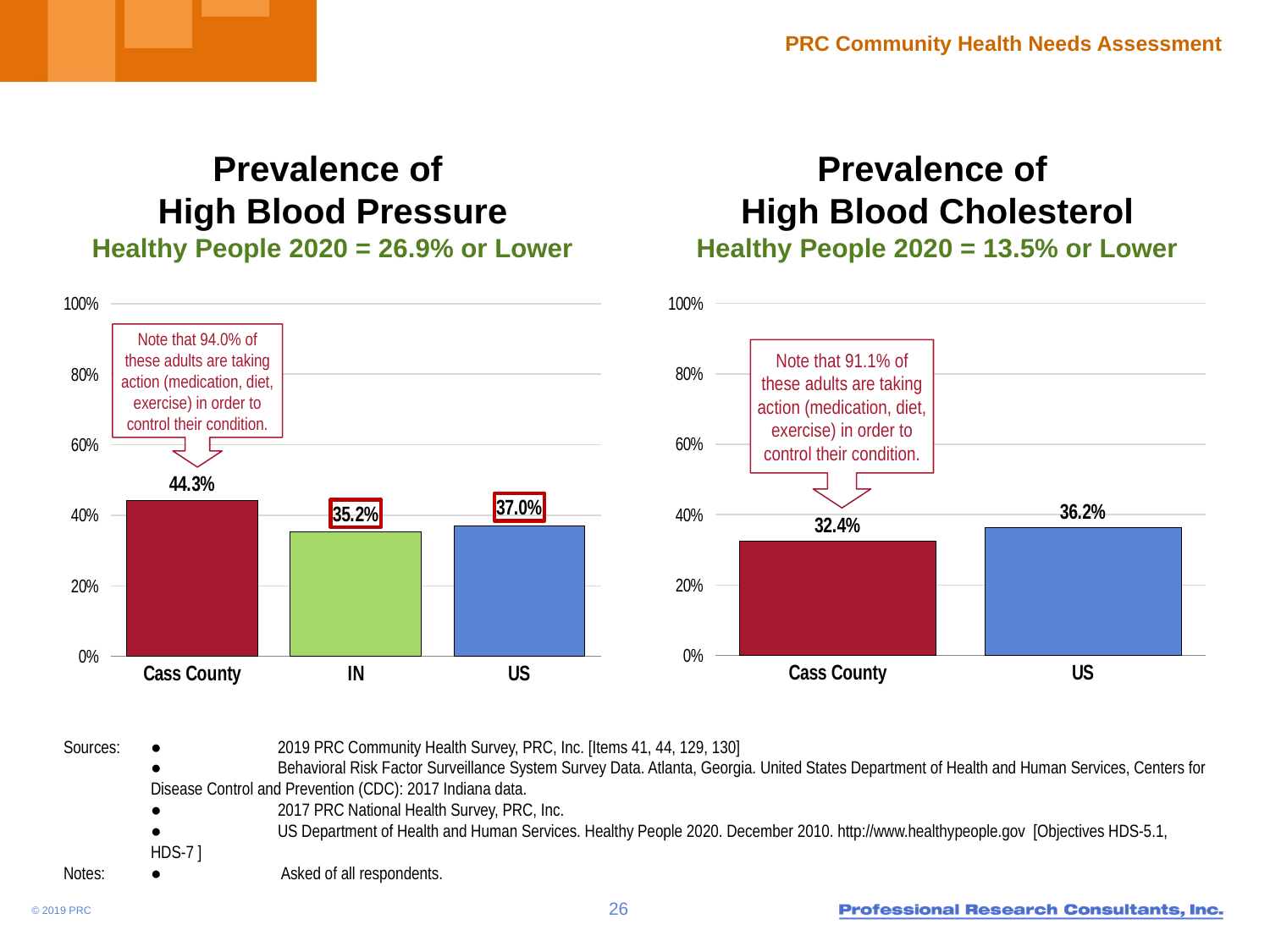
In the Prevalence of High Blood Pressure chart, what is the value for IN? 35.2% In the Prevalence of High Blood Cholesterol chart, which is larger, the value for Cass County or the value for US? US What Healthy People 2020 target is shown under the Prevalence of High Blood Cholesterol chart title? 13.5% or Lower In the Prevalence of High Blood Cholesterol chart, what is the difference between the US value and the Cass County value? 3.8% In the Prevalence of High Blood Pressure chart, which category has the highest value? Cass County How many categories are shown in the Prevalence of High Blood Cholesterol chart? 2 In the Prevalence of High Blood Pressure chart, is the value for Cass County greater or less than 40%? greater In the Prevalence of High Blood Pressure chart, what is the difference between the Cass County value and the US value? 7.3% What kind of chart is the Prevalence of High Blood Pressure chart? bar chart In the Prevalence of High Blood Cholesterol chart, what is the value for US? 36.2% In the Prevalence of High Blood Pressure chart, what is the value for Cass County? 44.3% In the Prevalence of High Blood Pressure chart, which category has the lowest value? IN